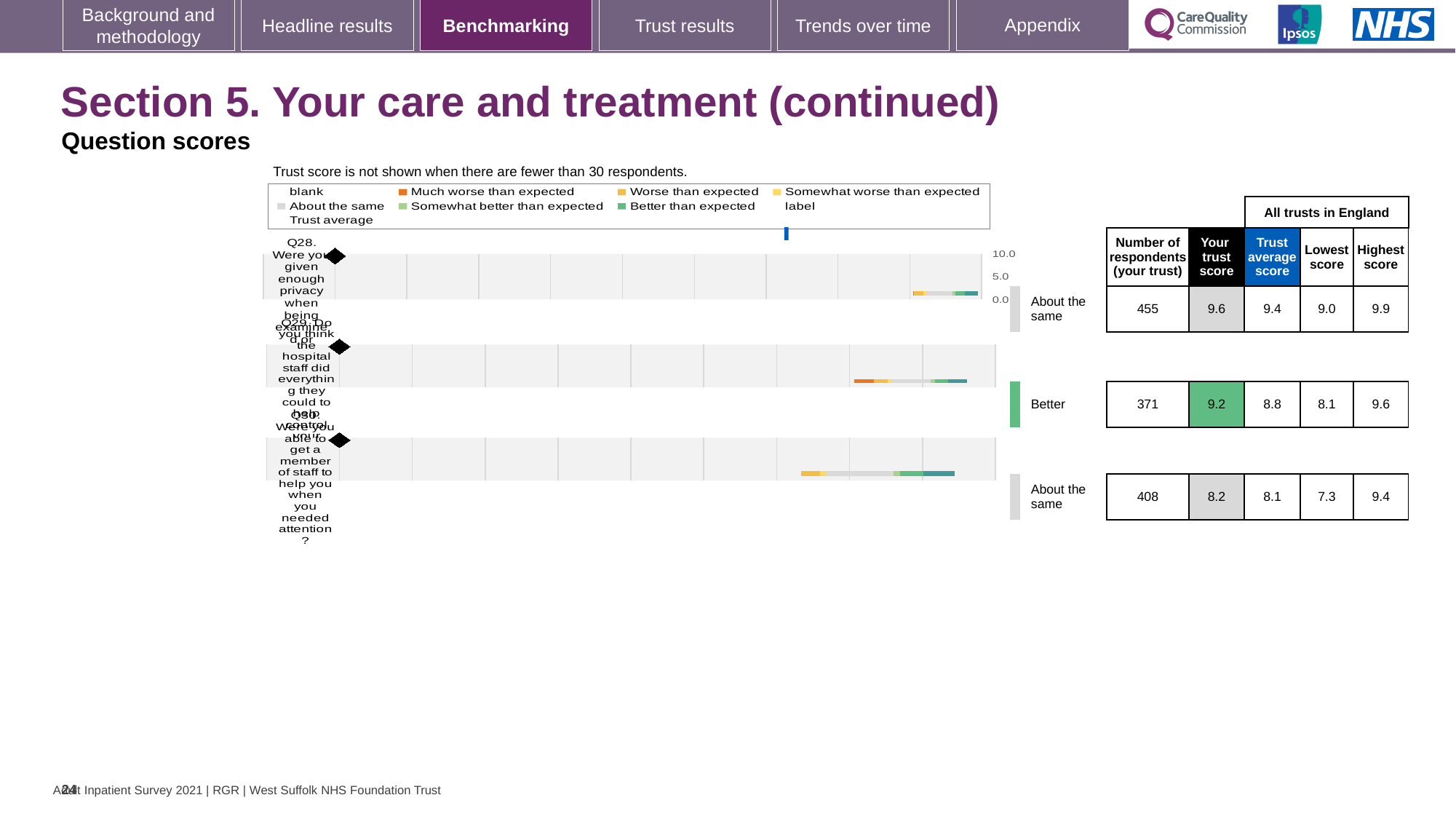
What is the trust average score across all trusts in England for Q30? 8.1 What is the trust score for Q28 (Were you given enough privacy when being examined or treated)? 9.6 Which of the three questions (Q28, Q29, Q30) has the lowest trust score? Q30 Which of the three questions (Q28, Q29, Q30) has the highest trust score? Q28 What benchmark category is shown for Q29? Better How many questions are plotted on the slide? 3 Is the trust score for Q28 higher or lower than the trust average score for Q28? higher What is the trust score for Q29 (Do you think the hospital staff did everything they could to help control your pain)? 9.2 What is the trust score for Q30 (Were you able to get a member of staff to help you when you needed attention)? 8.2 Is the trust score for Q30 greater or less than 5.0 on the chart axis? greater What is the difference between the trust score and the trust average score for Q29? 0.4 How many respondents answered Q29 at this trust? 371